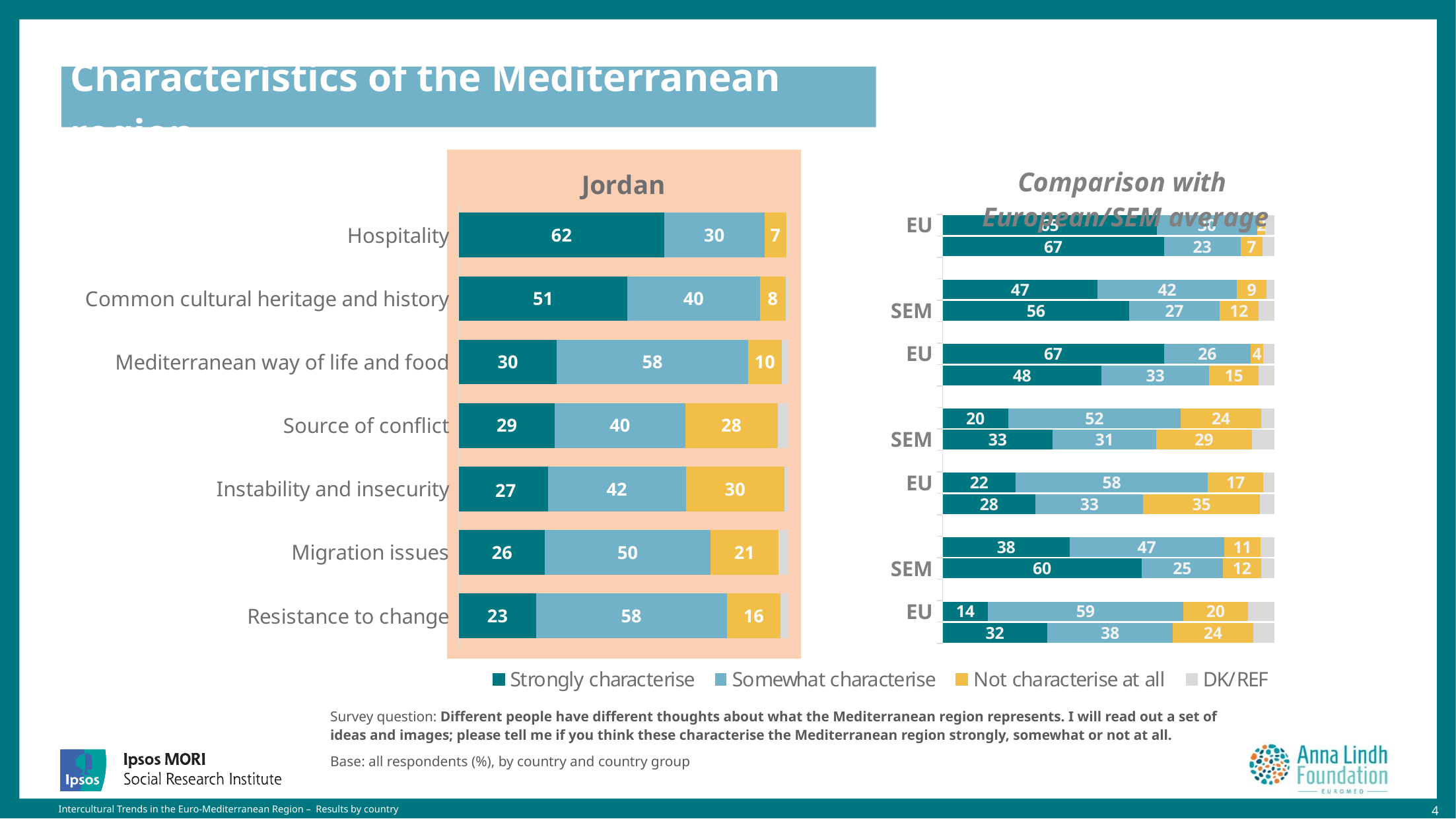
In the Jordan chart, what is the combined total of the three labelled segments for 'Source of conflict'? 97 In the Jordan chart, what is the 'Not characterise at all' value for 'Instability and insecurity'? 30 In the Jordan chart, which has a larger 'Not characterise at all' value: 'Source of conflict' or 'Migration issues'? Source of conflict In the Jordan chart, which characteristic has the lowest 'Strongly characterise' value? Resistance to change In the Jordan chart, what is the difference between the 'Strongly characterise' values for Hospitality and 'Common cultural heritage and history'? 11 In the Jordan chart, which characteristic has the highest 'Strongly characterise' value? Hospitality In the Jordan chart, what is the 'Somewhat characterise' value for 'Mediterranean way of life and food'? 58 What type of chart is the Jordan chart? Stacked bar chart Which legend entry is shown in yellow? Not characterise at all How many characteristics are listed in the Jordan chart? 7 How many series does the legend list? 4 In the Jordan chart, what percentage say hospitality strongly characterises the Mediterranean region? 62